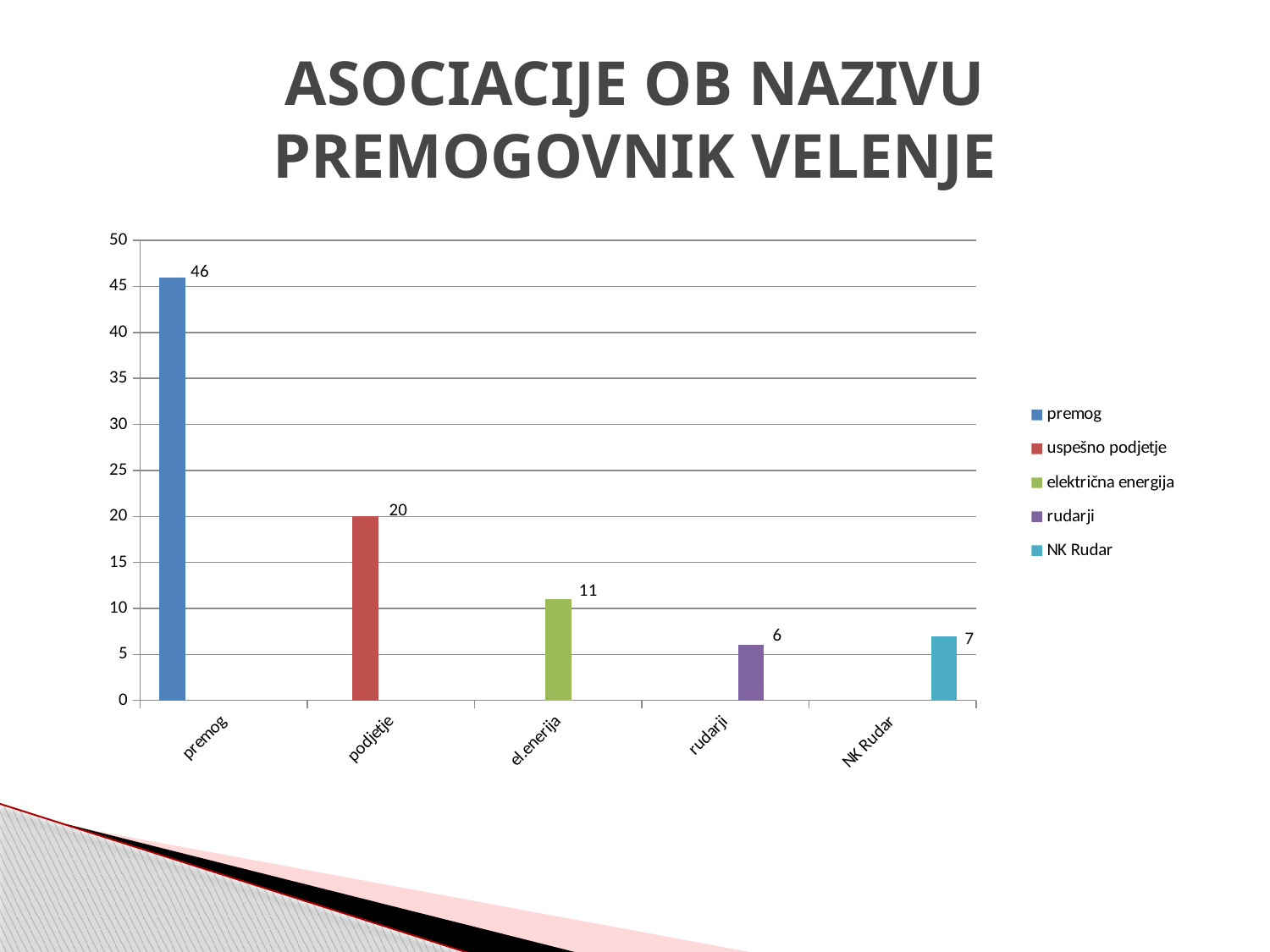
How many entries does the legend list? 5 What is the value for podjetje? 20 What is the value for premog? 46 What is the title of the slide? ASOCIACIJE OB NAZIVU PREMOGOVNIK VELENJE How many categories are shown on the x axis? 5 Which category has the highest value? premog What is the difference between the values for premog and podjetje? 26 What is the value for NK Rudar? 7 Which category has the lowest value? rudarji What is the value for el.enerija? 11 What kind of chart is shown on the slide? bar chart Which is larger, the value for el.enerija or the value for NK Rudar? el.enerija